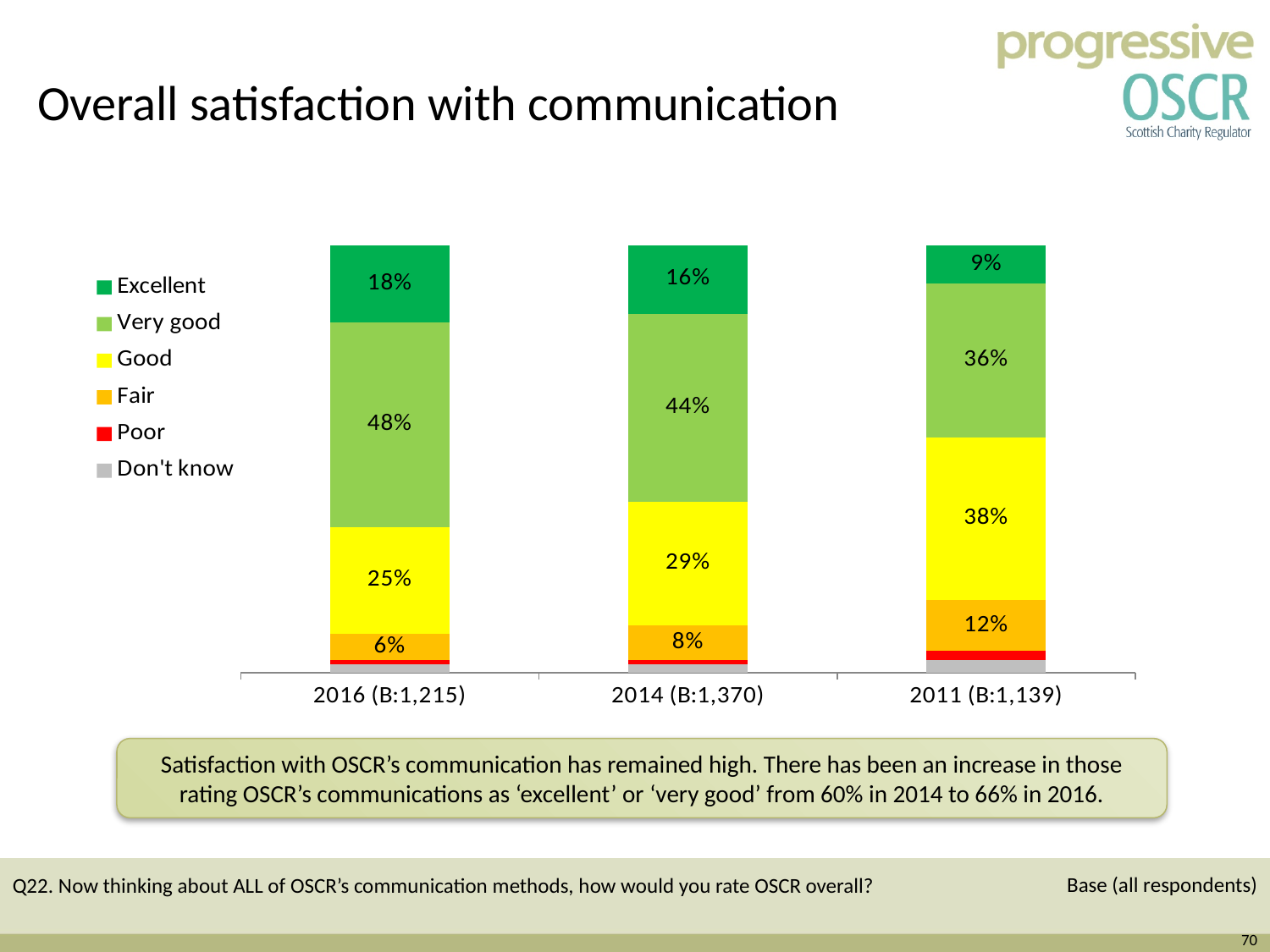
How many series does the legend list? 6 Which is larger: the 'Good' value for 2011 (B:1,139) or the 'Good' value for 2016 (B:1,215)? 2011 (B:1,139) What is the difference between the 'Very good' values for 2016 (B:1,215) and 2014 (B:1,370)? 4 percentage points Which colour represents 'Fair' in the legend? Orange How many years (categories) are shown on the x axis? 3 What is the 'Fair' value for 2011 (B:1,139)? 12% What percentage of respondents rated OSCR's communication as 'Excellent' in 2016 (B:1,215)? 18% Which year has the highest 'Excellent' percentage? 2016 (B:1,215) What percentage of respondents rated OSCR's communication as 'Very good' in 2011 (B:1,139)? 36% What kind of chart is shown on the slide? Stacked bar chart What is the 'Good' value for 2014 (B:1,370)? 29% Which year has the lowest 'Very good' percentage? 2011 (B:1,139)